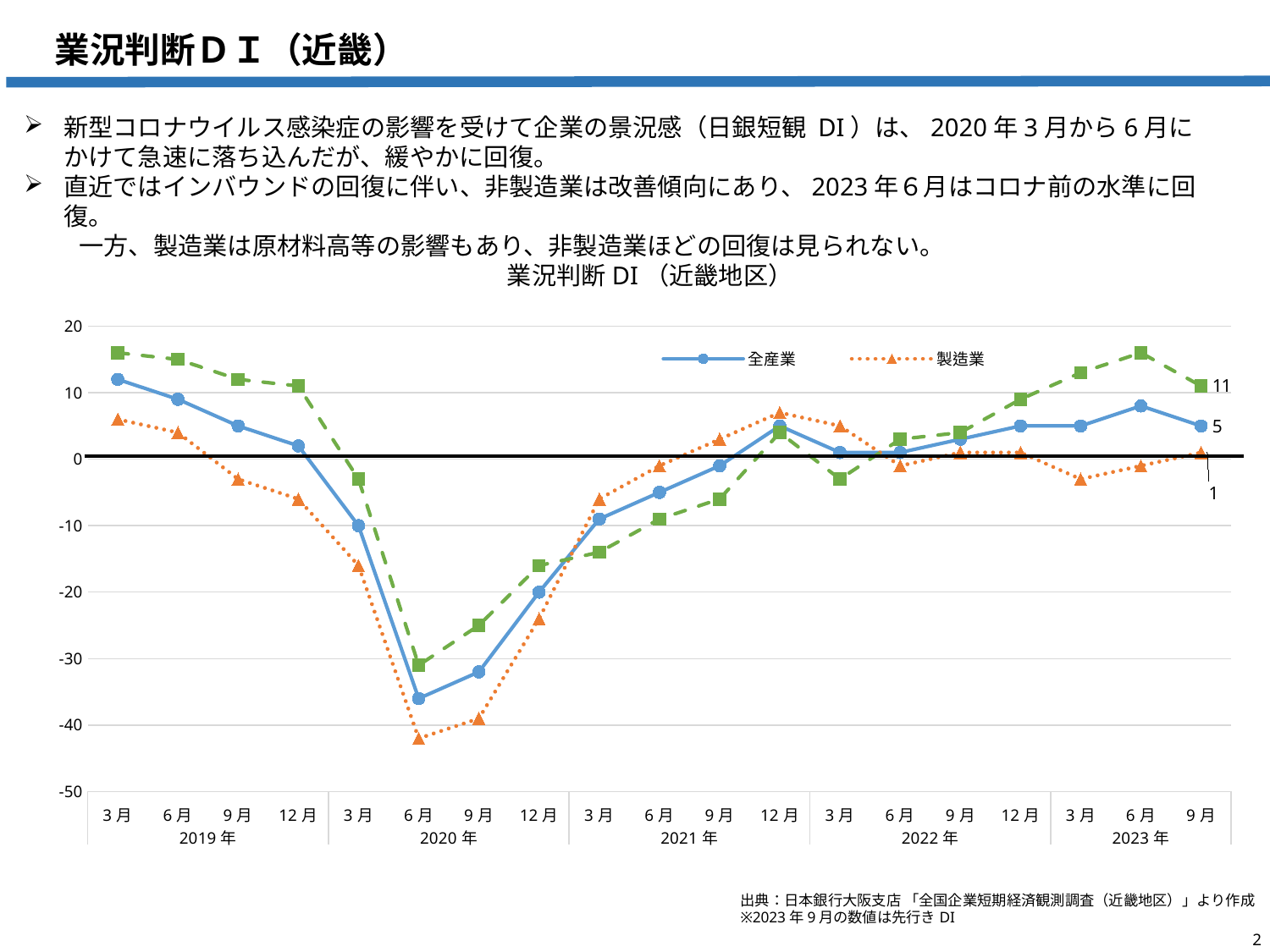
At which point on the x axis does 全産業 reach its lowest value? 2020年6月 What is the value of 製造業 at 2023年9月? 1 What is the value of 全産業 at 2023年9月? 5 What value is labelled at 2023年9月 on the green dashed line with square markers? 11 What is the difference between 全産業 and 製造業 at 2023年9月? 4 At 2023年9月, which is larger, 全産業 or 製造業? 全産業 What kind of chart is shown on the slide? Line chart Is the value for 全産業 at 2019年3月 greater or less than 10? greater Is the value for 製造業 at 2020年6月 greater or less than -40? less Does the 全産業 line rise or fall from 2020年3月 to 2020年6月? fall How many series does the legend list? 2 At which point on the x axis does 製造業 reach its lowest value? 2020年6月